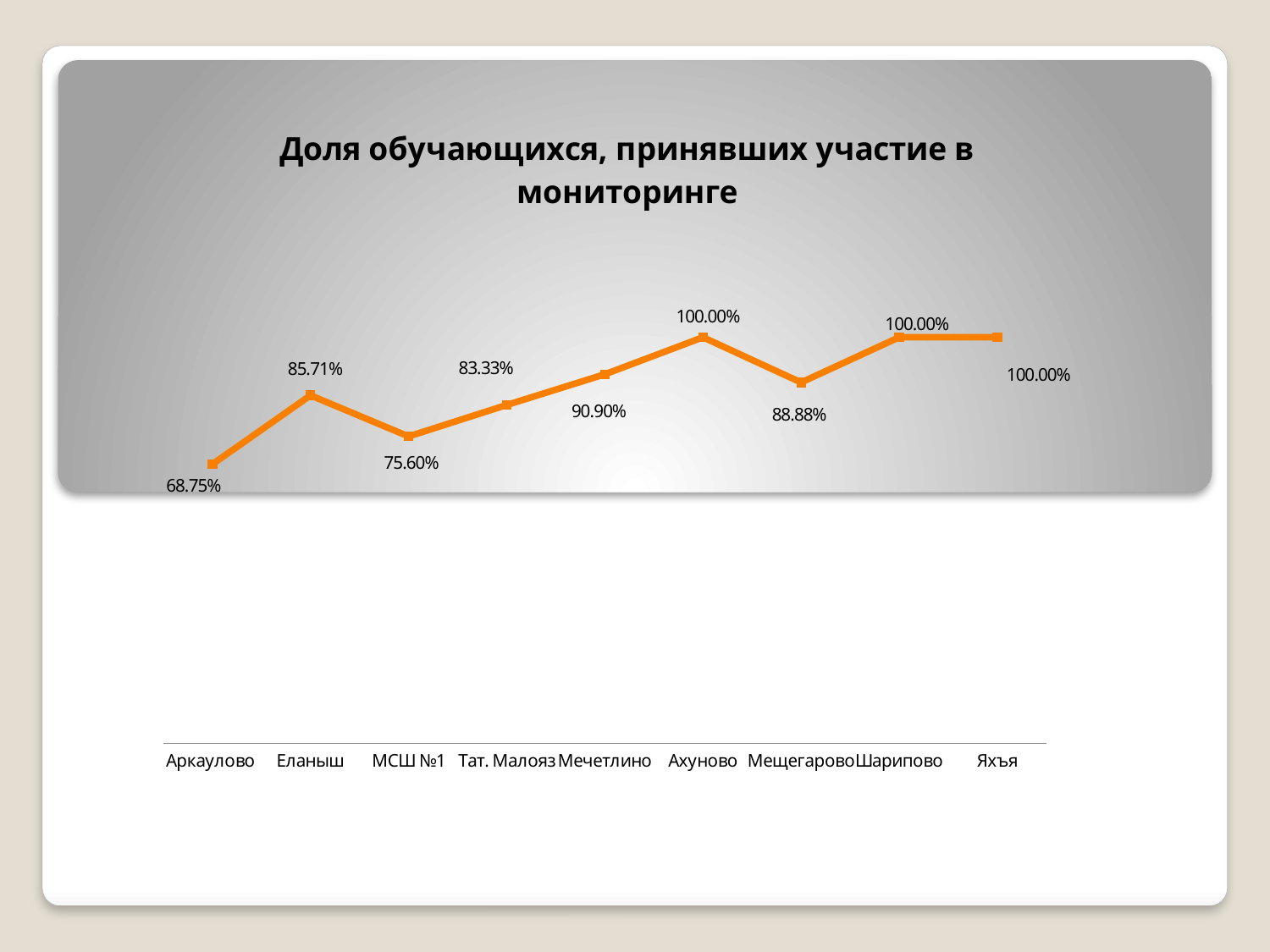
Which category has the lowest value? Аркаулово How many categories are plotted on the chart? 9 What is the value for МСШ №1? 75.60% What is the value for Аркаулово? 68.75% What is the value for Мещегарово? 88.88% What is the value for Мечетлино? 90.90% What is the difference between the values for Ахуново and Мещегарово? 11.12% What is the value for Еланыш? 85.71% What kind of chart is shown on the slide? Line chart What is the difference between the values for Еланыш and Аркаулово? 16.96% Which is larger, the value for Мечетлино or the value for Мещегарово? Мечетлино What is the title of the chart? Доля обучающихся, принявших участие в мониторинге